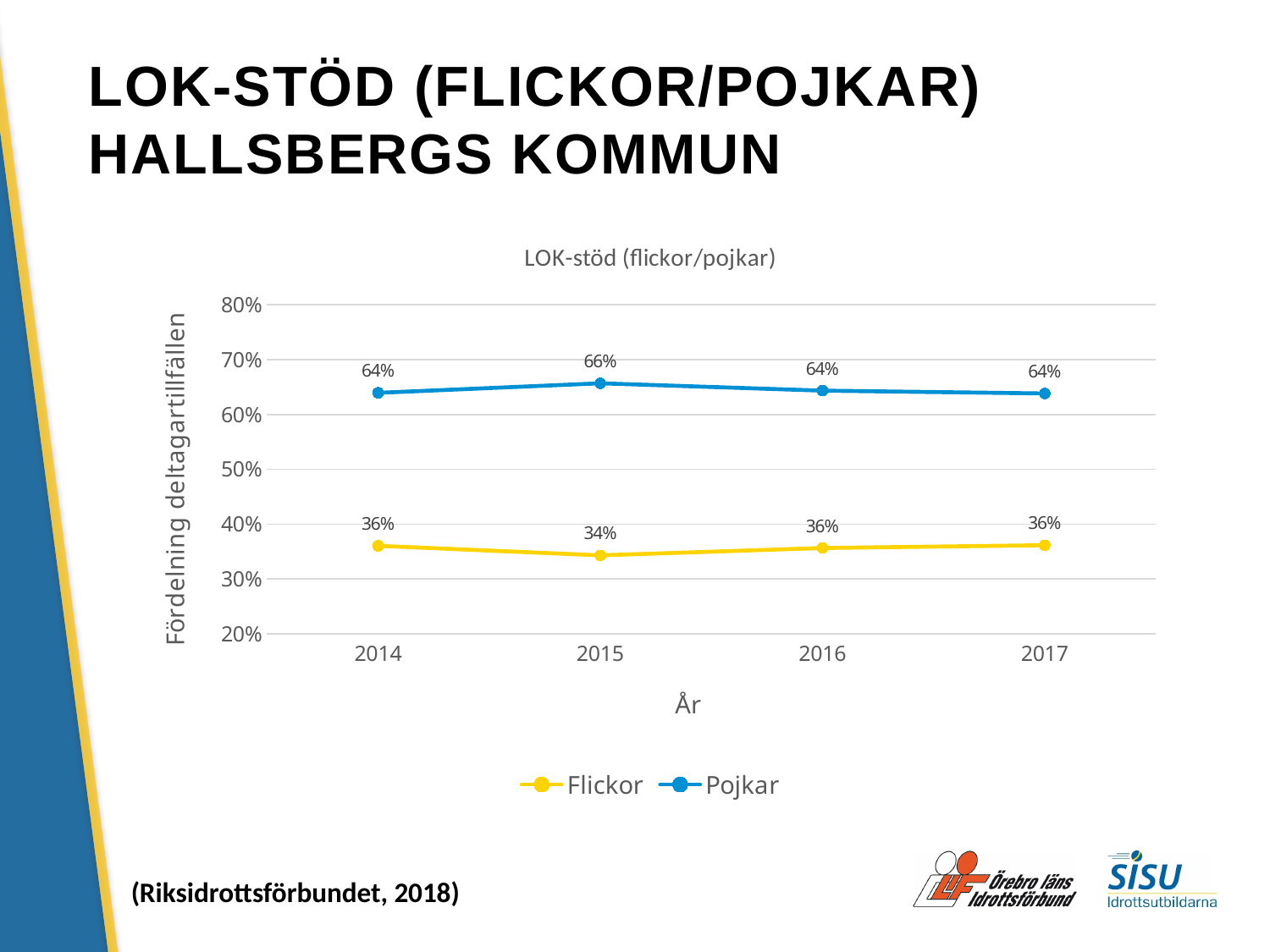
What is the label of the y axis? Fördelning deltagartillfällen In which year is the value for Pojkar highest? 2015 In which year is the value for Flickor lowest? 2015 What is the value for Flickor in 2017? 36% What is the value for Flickor in 2015? 34% How many series does the legend list? 2 Which series has the larger value in 2016, Flickor or Pojkar? Pojkar What is the difference between the Pojkar and Flickor values in 2015? 32% What kind of chart is shown? Line chart What is the difference between the Pojkar and Flickor values in 2014? 28% What is the value for Pojkar in 2015? 66% How many years are shown on the x axis? 4